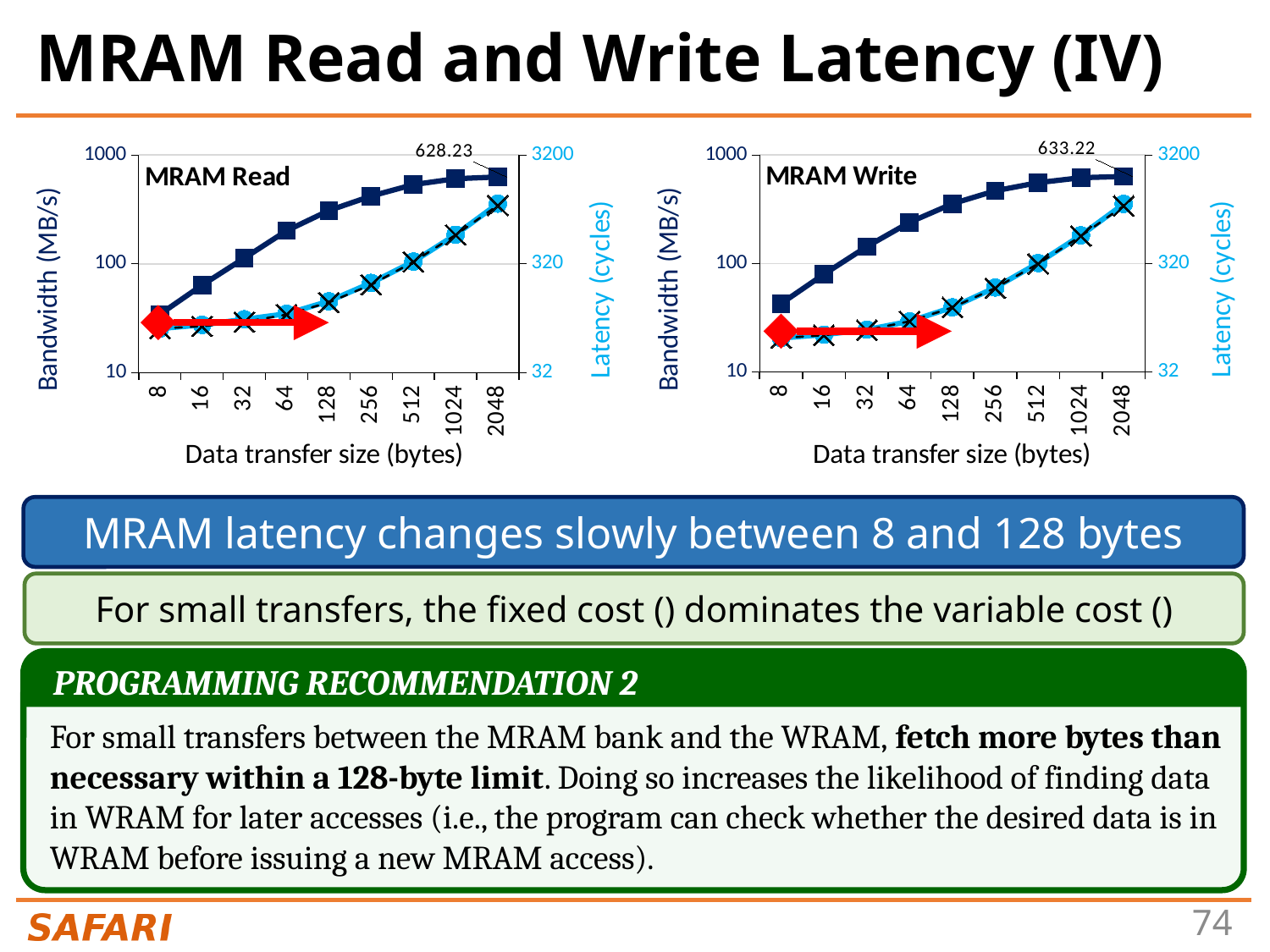
In the MRAM Read chart, how many data transfer sizes are shown on the x axis? 9 What kind of chart is the MRAM Write chart? Line chart In the MRAM Write chart, at which data transfer size is the bandwidth lowest? 8 In the MRAM Read chart, is the bandwidth at 8 bytes greater or less than 100 MB/s? less Which chart shows the higher labelled bandwidth at 2048 bytes, MRAM Read or MRAM Write? MRAM Write In the MRAM Read chart, is the latency at 2048 bytes greater or less than 320 cycles? greater In the MRAM Write chart, is the bandwidth at 512 bytes greater or less than 100 MB/s? greater What is the title of the x axis in the MRAM Read chart? Data transfer size (bytes) In the MRAM Write chart, what is the bandwidth value labelled at a data transfer size of 2048 bytes? 633.22 What is the difference between the labelled bandwidth at 2048 bytes in the MRAM Write chart and in the MRAM Read chart? 4.99 In the MRAM Read chart, what is the bandwidth value labelled at a data transfer size of 2048 bytes? 628.23 In the MRAM Read chart, does bandwidth rise or fall as the data transfer size increases? Rises